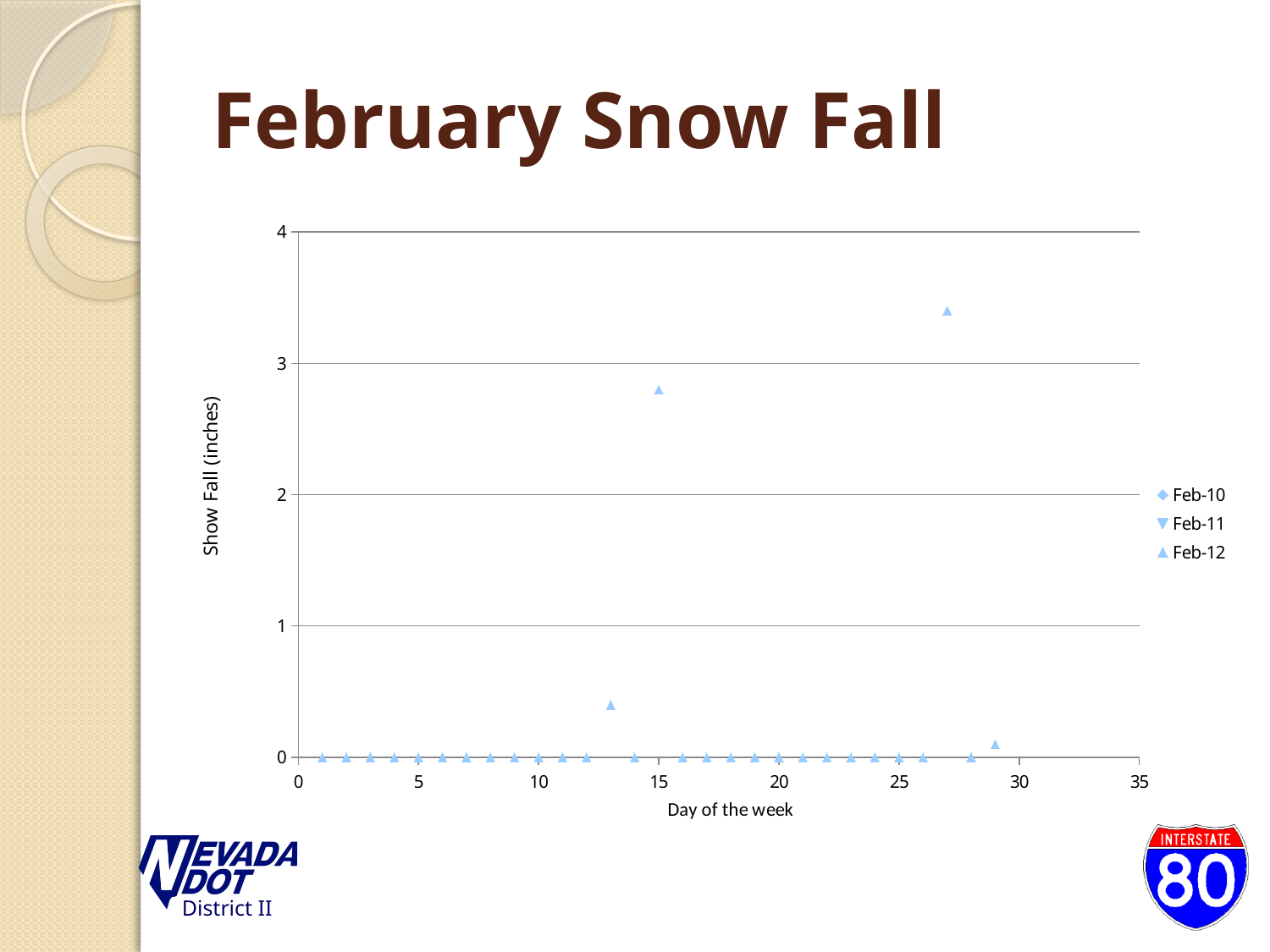
On which day of the month is the Feb-12 snow fall highest? 27 Is the Feb-12 snow fall value on day 27 greater or less than 3? greater What kind of chart is shown on the slide? scatter chart Is the Feb-12 snow fall value on day 13 greater or less than 1? less How many series does the legend list? 3 Is the Feb-12 snow fall value on day 15 greater or less than 2? greater What is the Feb-12 snow fall value on day 1? 0 What is the label on the x axis? Day of the week What is the title of the chart? February Snow Fall Which day has the larger Feb-12 snow fall, day 15 or day 27? day 27 Which day has the larger Feb-12 snow fall, day 13 or day 29? day 13